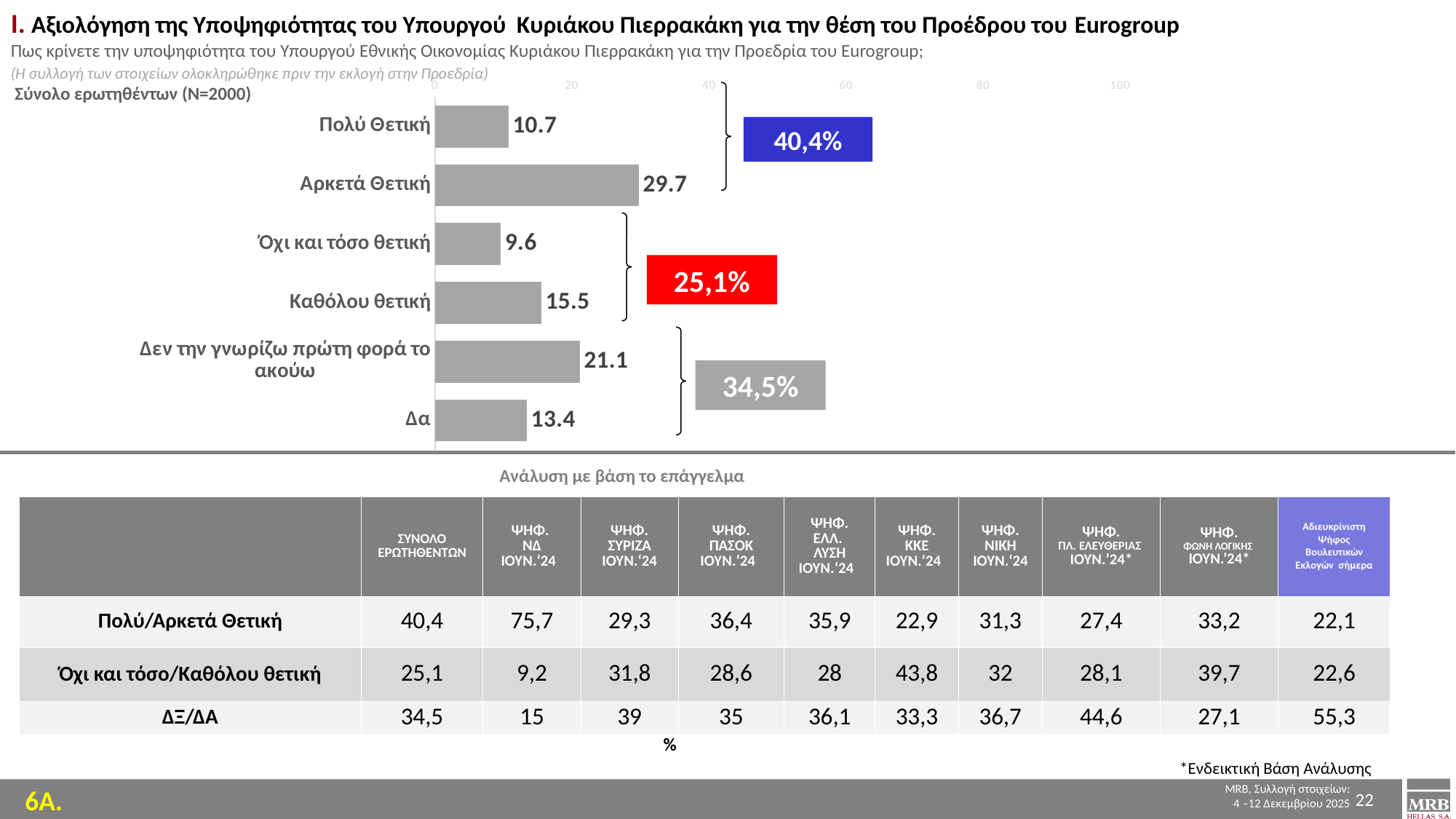
What is the value for "Δεν την γνωρίζω πρώτη φορά το ακούω" in the bar chart? 21.1 What is the difference between the values for "Αρκετά Θετική" and "Πολύ Θετική" in the bar chart? 19.0 How many categories are shown in the bar chart? 6 Is the value for "Αρκετά Θετική" in the bar chart greater or less than 20? greater Which is larger in the bar chart, the value for "Καθόλου θετική" or the value for "Δα"? Καθόλου θετική What is the difference between the values for "Δεν την γνωρίζω πρώτη φορά το ακούω" and "Δα" in the bar chart? 7.7 Which category has the lowest value in the bar chart? Όχι και τόσο θετική What kind of chart is shown on the slide? bar chart What is the value for "Καθόλου θετική" in the bar chart? 15.5 What is the value for "Πολύ Θετική" in the bar chart? 10.7 Which category has the highest value in the bar chart? Αρκετά Θετική What is the value for "Αρκετά Θετική" in the bar chart? 29.7